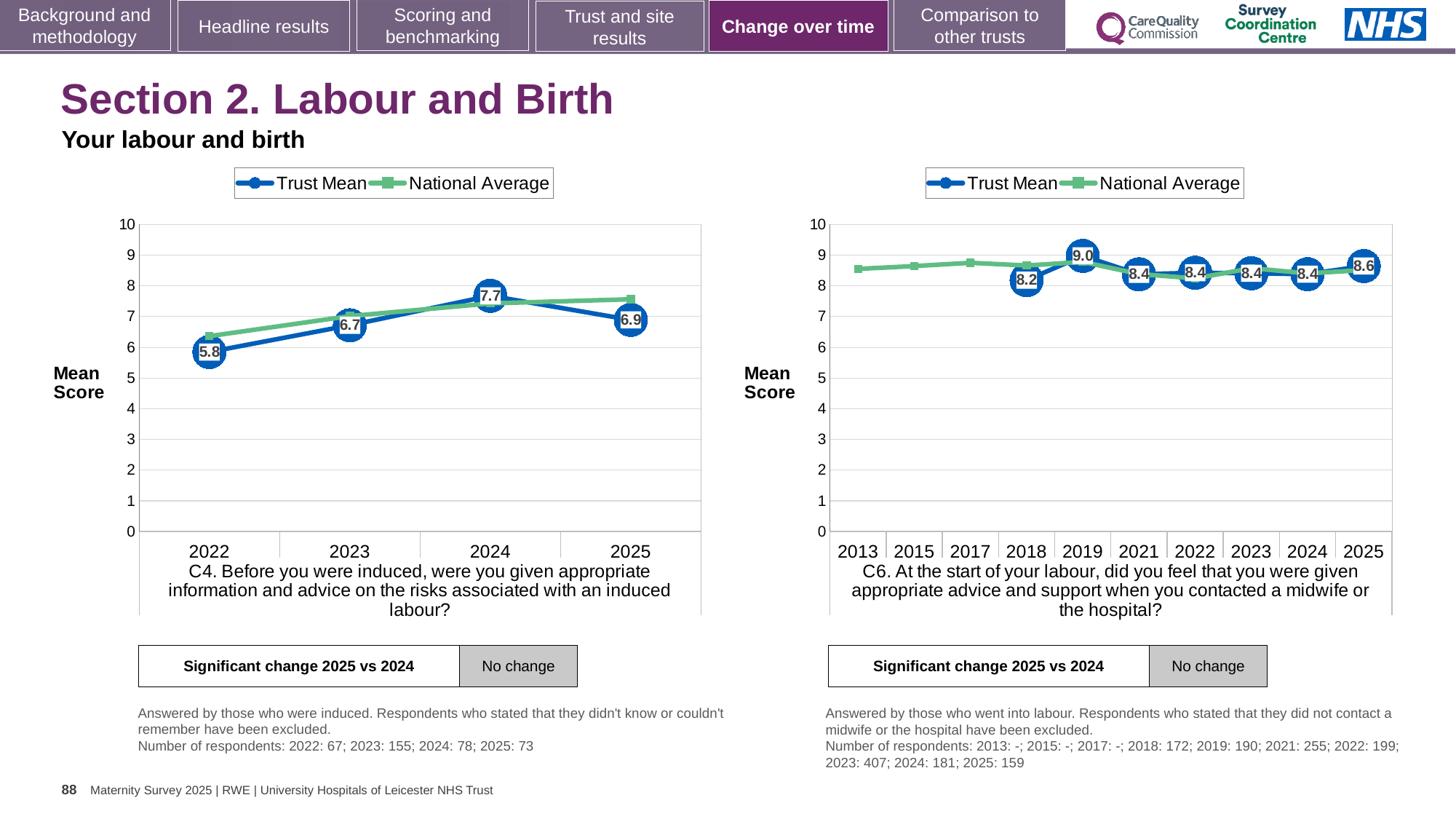
In the C6 chart on the right, how many years are shown on the x axis? 10 In the C4 chart on the left, how many series does the legend list? 2 In the C4 chart on the left, which year has the lowest Trust Mean score? 2022 In the C6 chart on the right, is the Trust Mean score for 2018 greater or less than the Trust Mean score for 2019? less In the C6 chart on the right, what is the Trust Mean score for 2019? 9.0 What kind of chart is the C4 chart on the left? Line chart In the C4 chart on the left, what is the Trust Mean score for 2024? 7.7 In the C4 chart on the left, which year has the highest Trust Mean score? 2024 In the C6 chart on the right, what is the Trust Mean score for 2025? 8.6 In the C4 chart on the left, what is the Trust Mean score for 2022? 5.8 In the C6 chart on the right, which year has the lowest Trust Mean score? 2018 In the C4 chart on the left, what is the difference between the Trust Mean scores for 2024 and 2025? 0.8